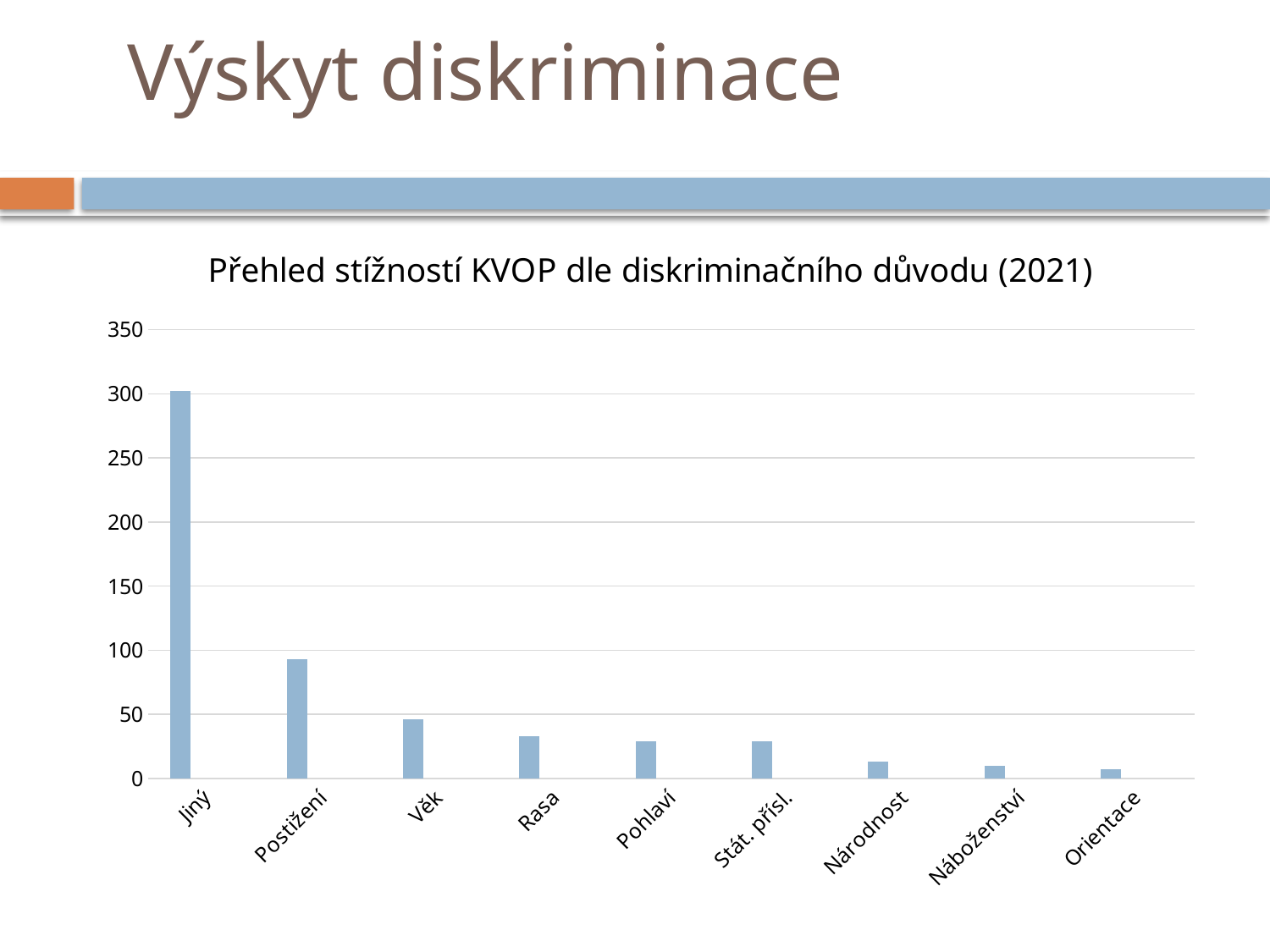
Which category has the lowest value in the chart? Orientace How many categories are shown on the x axis of the chart? 9 Which is larger, the value for Postižení or the value for Věk? Postižení Do the values generally rise or fall from left to right along the x axis? fall What kind of chart is shown on the slide? bar chart Is the value for Národnost greater or less than 50? less Which is larger, the value for Rasa or the value for Náboženství? Rasa Which category has the highest value in the chart? Jiný What is the title of the chart? Přehled stížností KVOP dle diskriminačního důvodu (2021) Is the value for Postižení greater or less than 100? less